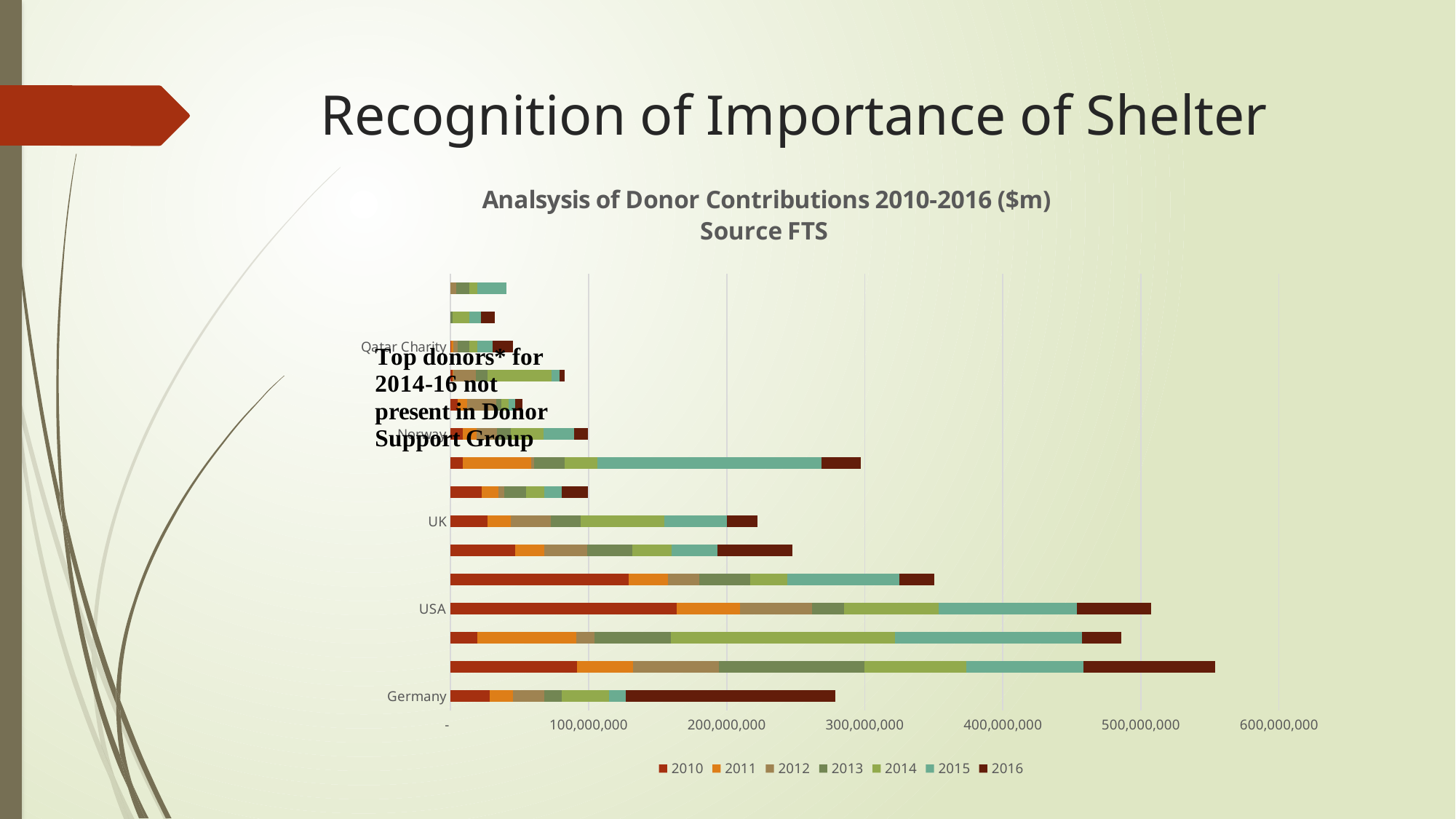
What is the title of the chart? Analsysis of Donor Contributions 2010-2016 ($m) Source FTS How many bars are plotted in the chart? 15 Is the total value of the bar for Germany greater or less than 300,000,000? less How many series does the legend list? 7 Is the total value of the bar for UK greater or less than 200,000,000? greater Is the total value of the bar for Germany greater or less than 200,000,000? greater Which has a larger total bar, USA or UK? USA Which year's segment is the largest in the Germany bar? 2016 Which has a larger total bar, Germany or UK? Germany What kind of chart is shown on the slide? Stacked bar chart